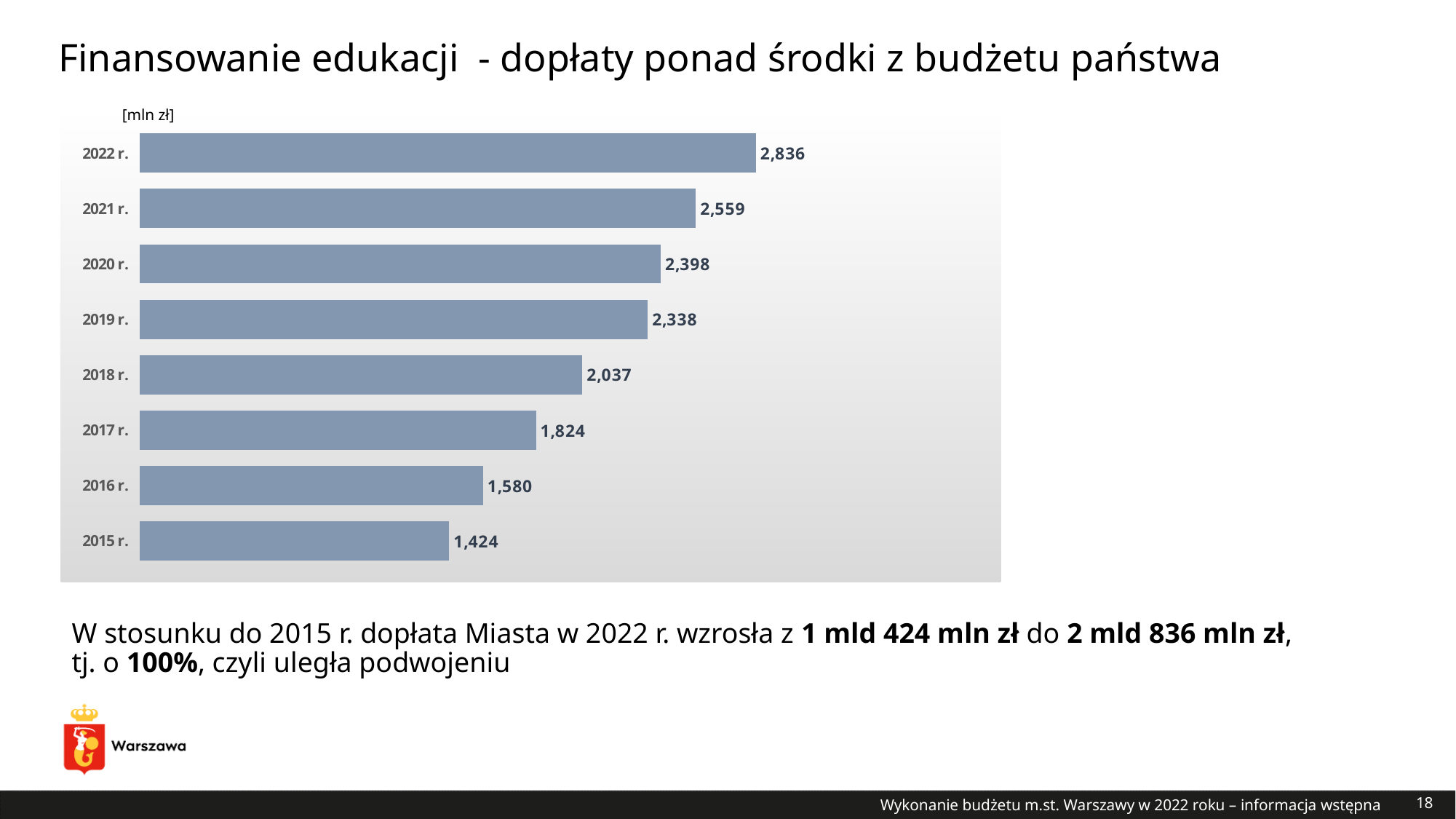
Which year has the lowest value? 2015 r. How many years are shown in the chart? 8 What is the value for 2015 r.? 1,424 Which year has the highest value? 2022 r. Do the values rise or fall from 2015 r. to 2022 r.? rise What is the value for 2022 r.? 2,836 Which is larger, the value for 2017 r. or the value for 2016 r.? 2017 r. What is the difference between the values for 2020 r. and 2019 r.? 60 What is the value for 2018 r.? 2,037 What kind of chart is shown on the slide? bar chart What unit is shown above the chart? [mln zł] What is the difference between the values for 2022 r. and 2015 r.? 1,412